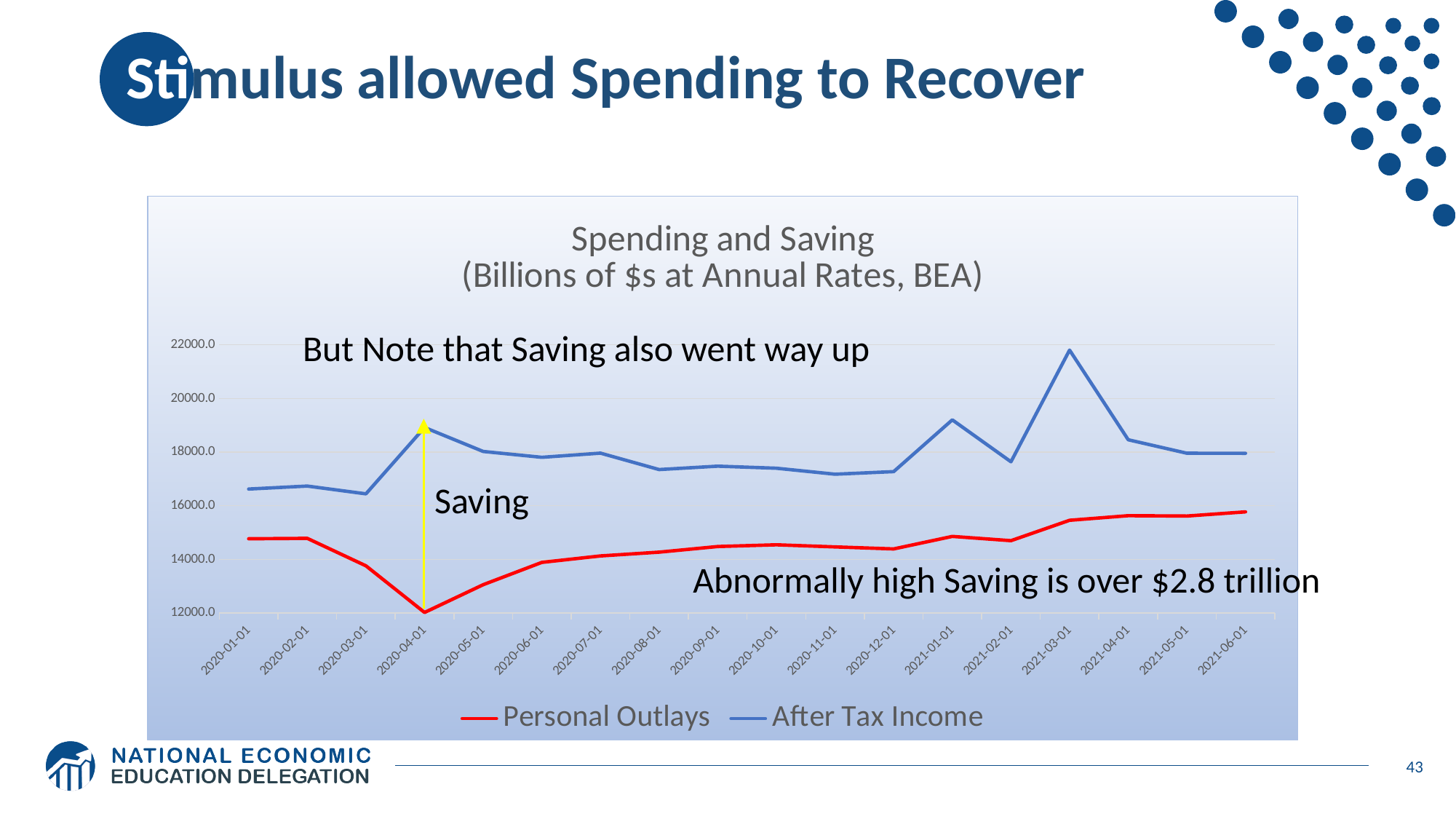
Is the value of After Tax Income at 2021-03-01 greater or less than 20000.0? greater Is the value of Personal Outlays at 2020-01-01 greater or less than 16000.0? less What is the title of the chart? Spending and Saving (Billions of $s at Annual Rates, BEA) Which series has the higher value at 2020-04-01, Personal Outlays or After Tax Income? After Tax Income At which date do Personal Outlays reach their lowest value? 2020-04-01 Is the value of After Tax Income at 2020-01-01 greater or less than 16000.0? greater What kind of chart is shown on the slide? Line chart How many dates are shown along the x axis? 18 What colour is the After Tax Income line? Blue How many series does the legend list? 2 At which date does After Tax Income reach its highest value? 2021-03-01 Do Personal Outlays generally rise or fall from 2020-04-01 to 2021-06-01? Rise